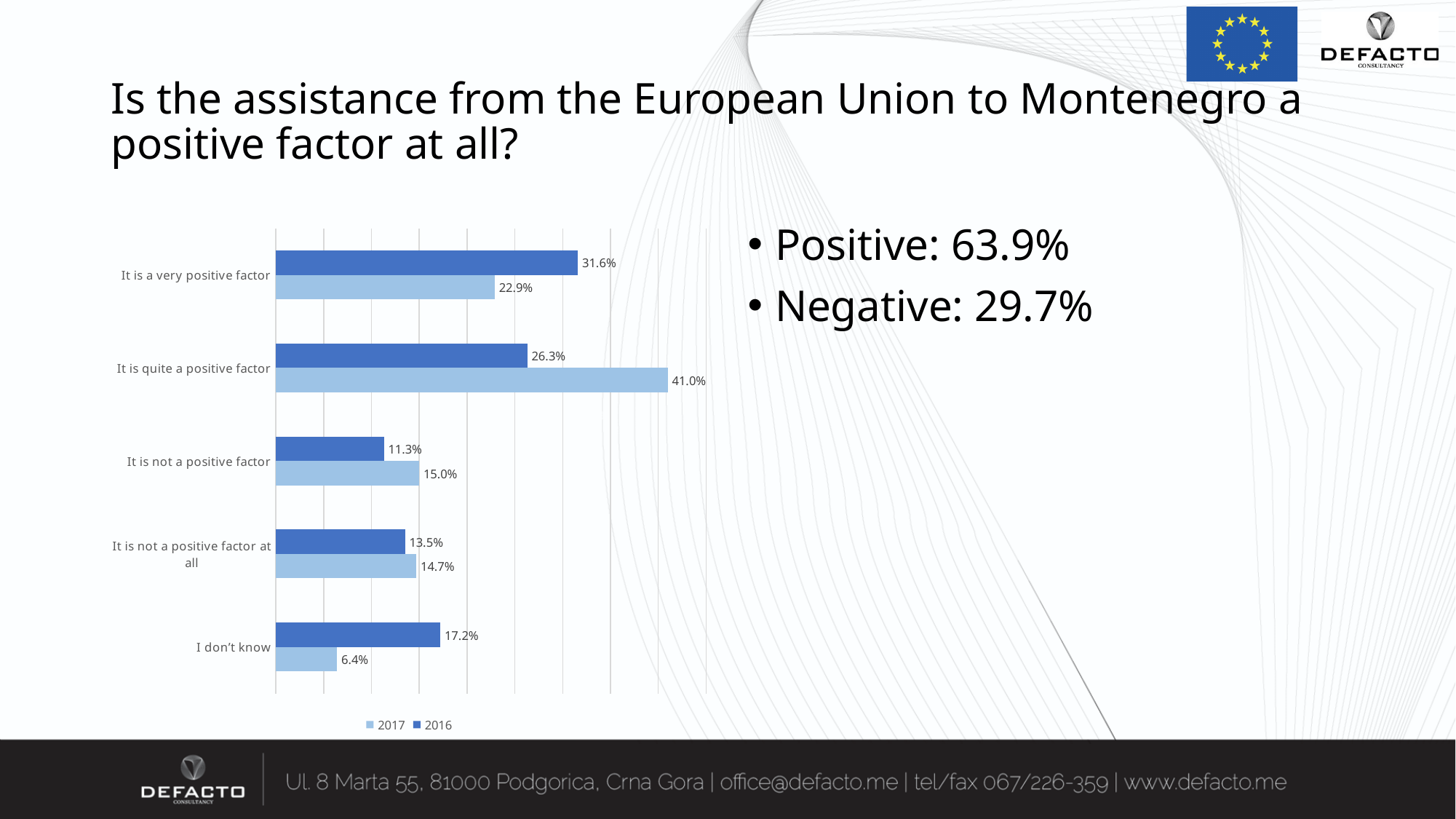
How many series does the legend list? 2 What is the difference between the 2017 and 2016 values for "It is quite a positive factor"? 14.7% What is the 2016 value for "It is a very positive factor"? 31.6% What is the 2016 value for "It is not a positive factor at all"? 13.5% What is the 2017 value for "I don't know"? 6.4% What is the 2017 value for "It is quite a positive factor"? 41.0% What kind of chart is shown on the slide? Bar chart How many categories are shown on the chart? 5 What is the difference between the 2016 and 2017 values for "I don't know"? 10.8% For "It is a very positive factor", which year has the larger value, 2016 or 2017? 2016 Which category has the highest 2017 value? It is quite a positive factor Which category has the lowest 2016 value? It is not a positive factor